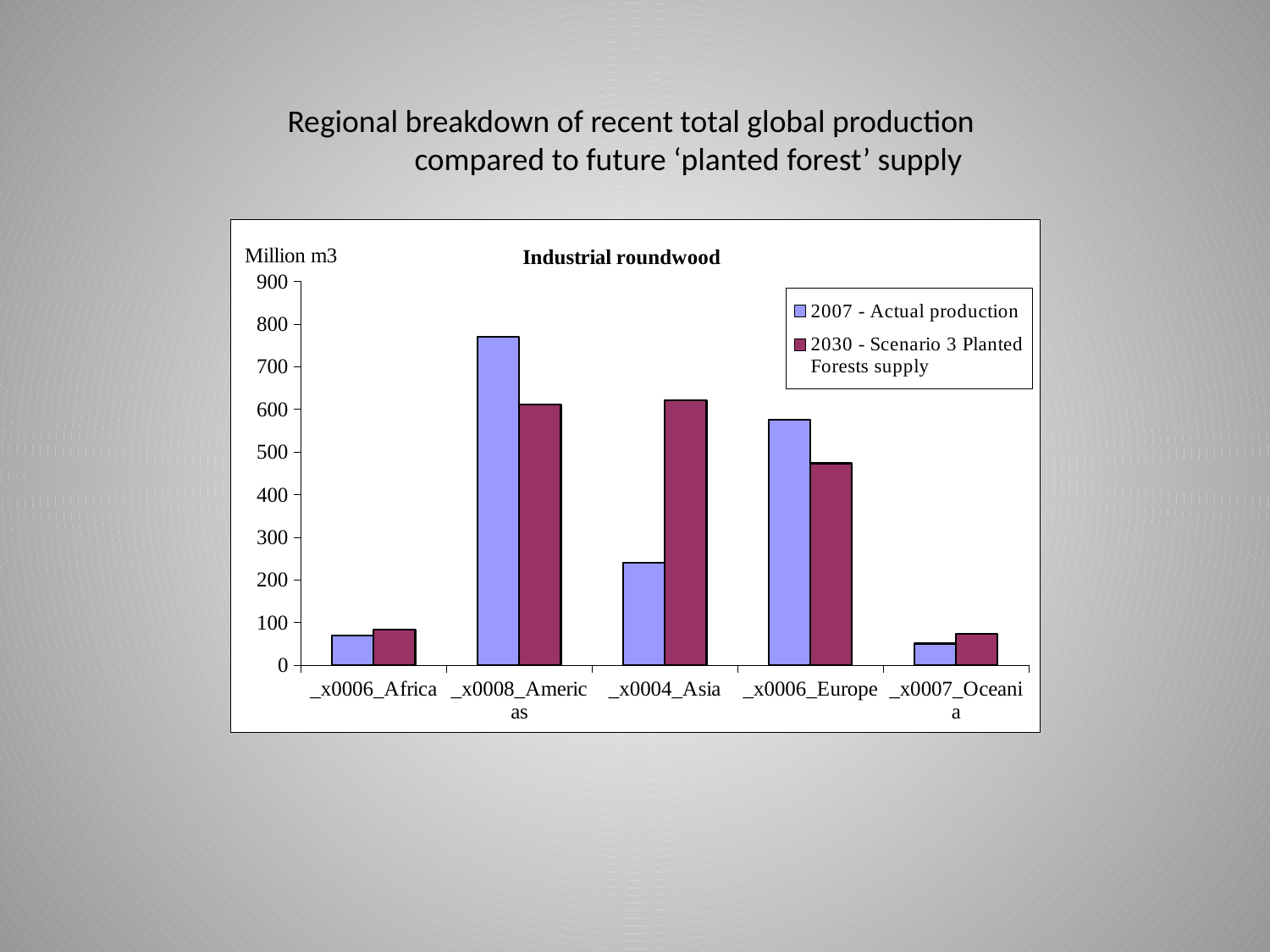
Which region has the highest 2007 - Actual production value? Americas Is the 2007 - Actual production value for the Americas greater or less than 700? greater How many series does the legend list? 2 Which region has the lowest 2007 - Actual production value? Oceania For Europe, which is larger: 2007 - Actual production or 2030 - Scenario 3 Planted Forests supply? 2007 - Actual production What unit is shown on the y axis of the chart? Million m3 Is the 2030 - Scenario 3 Planted Forests supply value for Europe greater or less than 500? less For Asia, which is larger: 2007 - Actual production or 2030 - Scenario 3 Planted Forests supply? 2030 - Scenario 3 Planted Forests supply Is the 2007 - Actual production value for Africa greater or less than 100? less How many regions are shown on the x axis of the chart? 5 What kind of chart is shown on the slide? bar chart